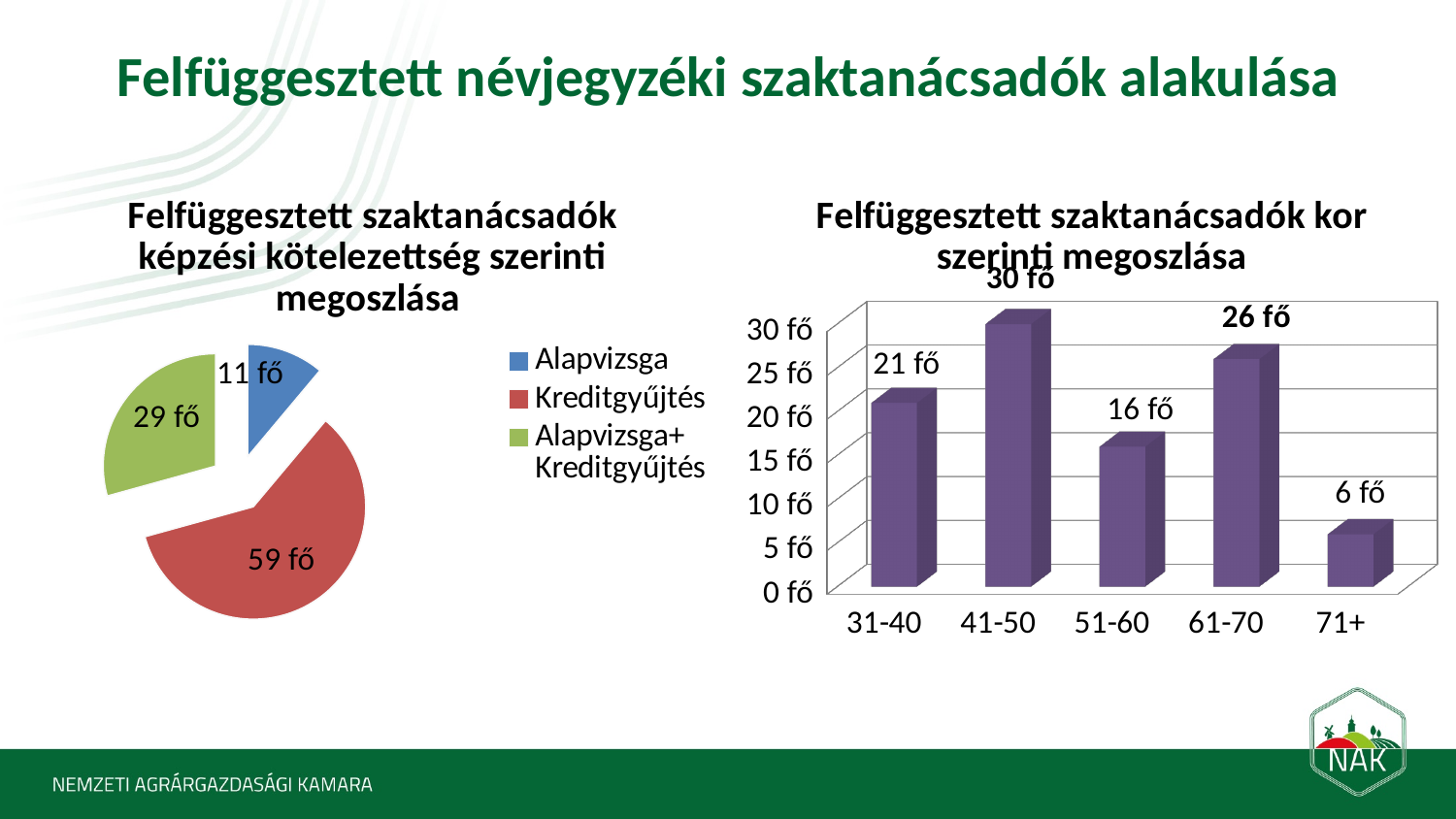
In the pie chart titled 'Felfüggesztett szaktanácsadók képzési kötelezettség szerinti megoszlása', how many categories does the legend list? 3 In the chart titled 'Felfüggesztett szaktanácsadók kor szerinti megoszlása', what is the value for the 41-50 age group? 30 fő In the pie chart titled 'Felfüggesztett szaktanácsadók képzési kötelezettség szerinti megoszlása', which category has the smallest slice? Alapvizsga In the chart titled 'Felfüggesztett szaktanácsadók kor szerinti megoszlása', which age group has the highest value? 41-50 In the chart titled 'Felfüggesztett szaktanácsadók kor szerinti megoszlása', what is the difference between the values for 61-70 and 51-60? 10 fő What kind of chart is the one titled 'Felfüggesztett szaktanácsadók kor szerinti megoszlása'? Bar chart In the chart titled 'Felfüggesztett szaktanácsadók kor szerinti megoszlása', how many age groups are shown on the x axis? 5 In the pie chart titled 'Felfüggesztett szaktanácsadók képzési kötelezettség szerinti megoszlása', what is the difference between the values for Alapvizsga+Kreditgyűjtés and Alapvizsga? 18 fő In the chart titled 'Felfüggesztett szaktanácsadók kor szerinti megoszlása', which is larger: the value for 31-40 or the value for 61-70? 61-70 In the pie chart titled 'Felfüggesztett szaktanácsadók képzési kötelezettség szerinti megoszlása', what is the value for Kreditgyűjtés? 59 fő In the chart titled 'Felfüggesztett szaktanácsadók kor szerinti megoszlása', what is the value for the 71+ age group? 6 fő In the chart titled 'Felfüggesztett szaktanácsadók kor szerinti megoszlása', which age group has the lowest value? 71+